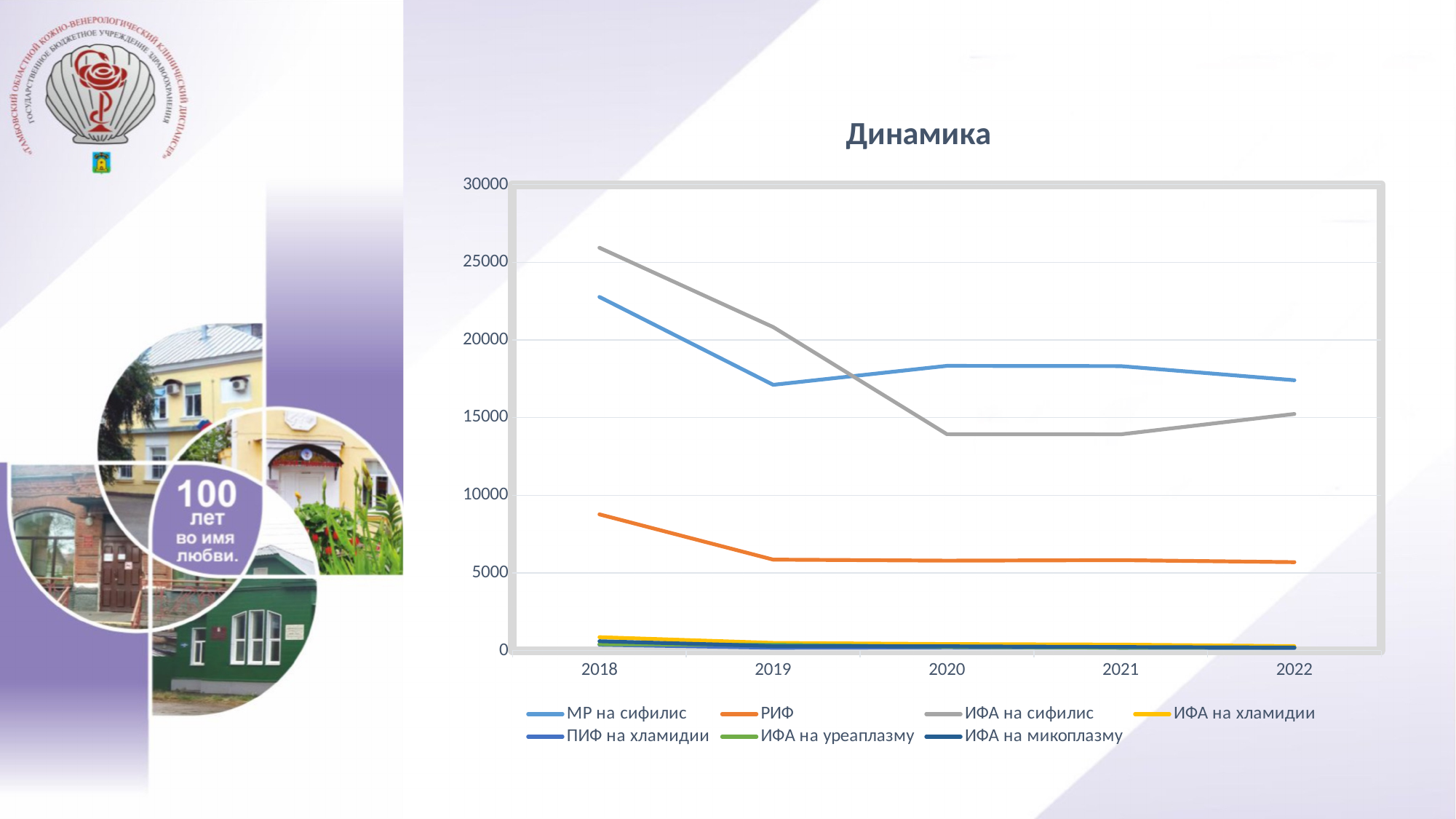
In 2018, which series has the higher value: ИФА на сифилис or МР на сифилис? ИФА на сифилис What kind of chart is shown on the slide? line chart Which series has the highest value in 2018? ИФА на сифилис In 2020, which series has the higher value: МР на сифилис or ИФА на сифилис? МР на сифилис How many years are shown on the x axis? 5 How many series does the legend list? 7 Is the value for МР на сифилис in 2019 greater or less than 15000? greater Is the value for ИФА на сифилис in 2021 greater or less than 15000? less Does the ИФА на сифилис line rise or fall from 2018 to 2020? fall Is the value for РИФ in 2018 greater or less than 10000? less What is the title of the chart? Динамика